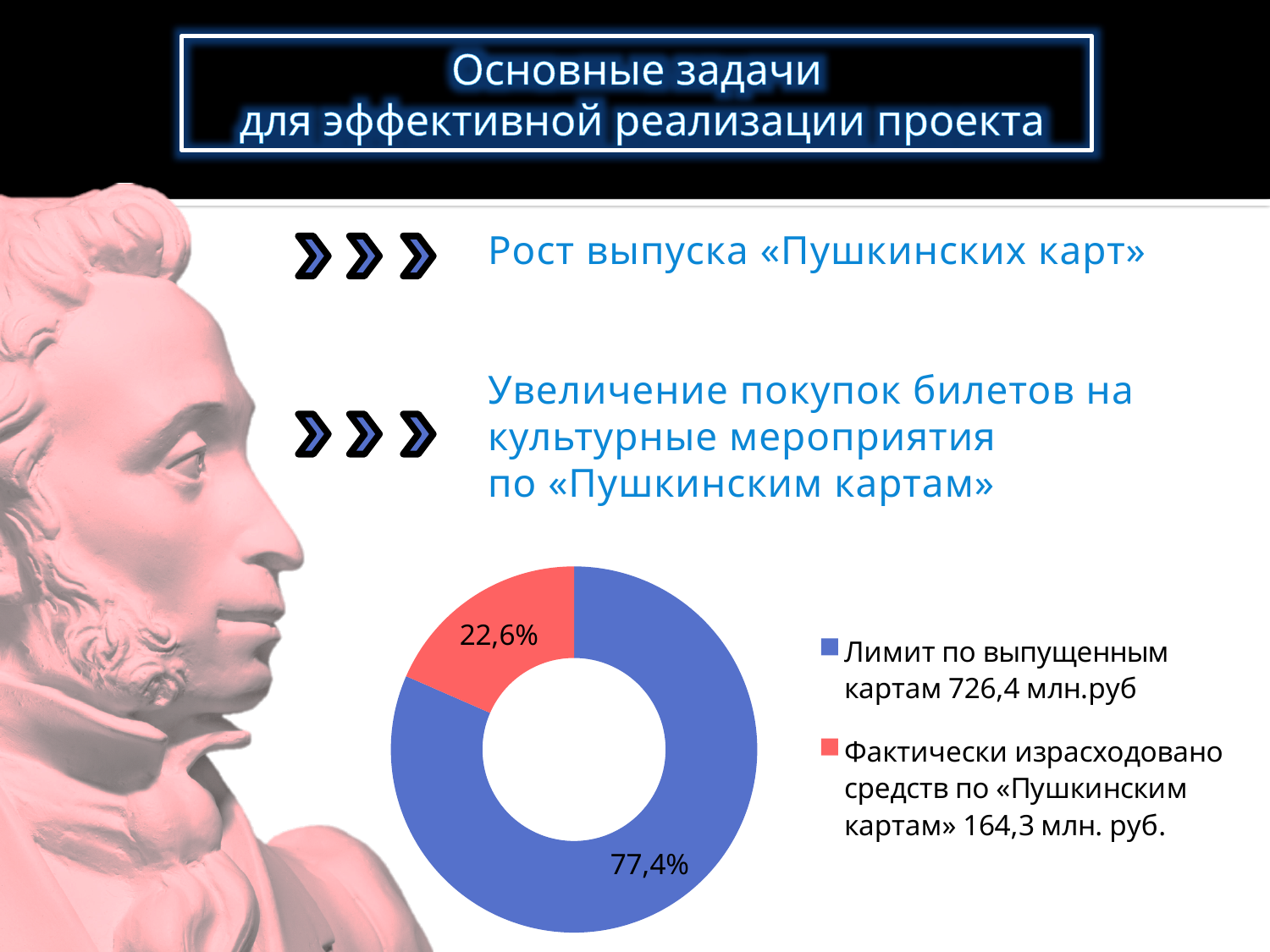
What colour is the slice representing «Фактически израсходовано средств по «Пушкинским картам»»? Red Which legend entry corresponds to the smallest slice of the chart? Фактически израсходовано средств по «Пушкинским картам» 164,3 млн. руб. What amount in млн.руб is given in the legend for «Лимит по выпущенным картам»? 726,4 млн.руб What kind of chart is shown on the slide? Doughnut (pie) chart What is the sum of the two percentages shown on the chart? 100% What percentage is shown for the red slice labelled «Фактически израсходовано средств по «Пушкинским картам» 164,3 млн. руб.»? 22,6% How many slices does the chart have? 2 Which legend entry corresponds to the largest slice of the chart? Лимит по выпущенным картам 726,4 млн.руб What percentage is shown for the blue slice labelled «Лимит по выпущенным картам 726,4 млн.руб»? 77,4% What is the difference in percentage points between the 77,4% slice and the 22,6% slice? 54,8 Which slice is larger: the blue one or the red one? The blue one How many entries does the chart legend list? 2